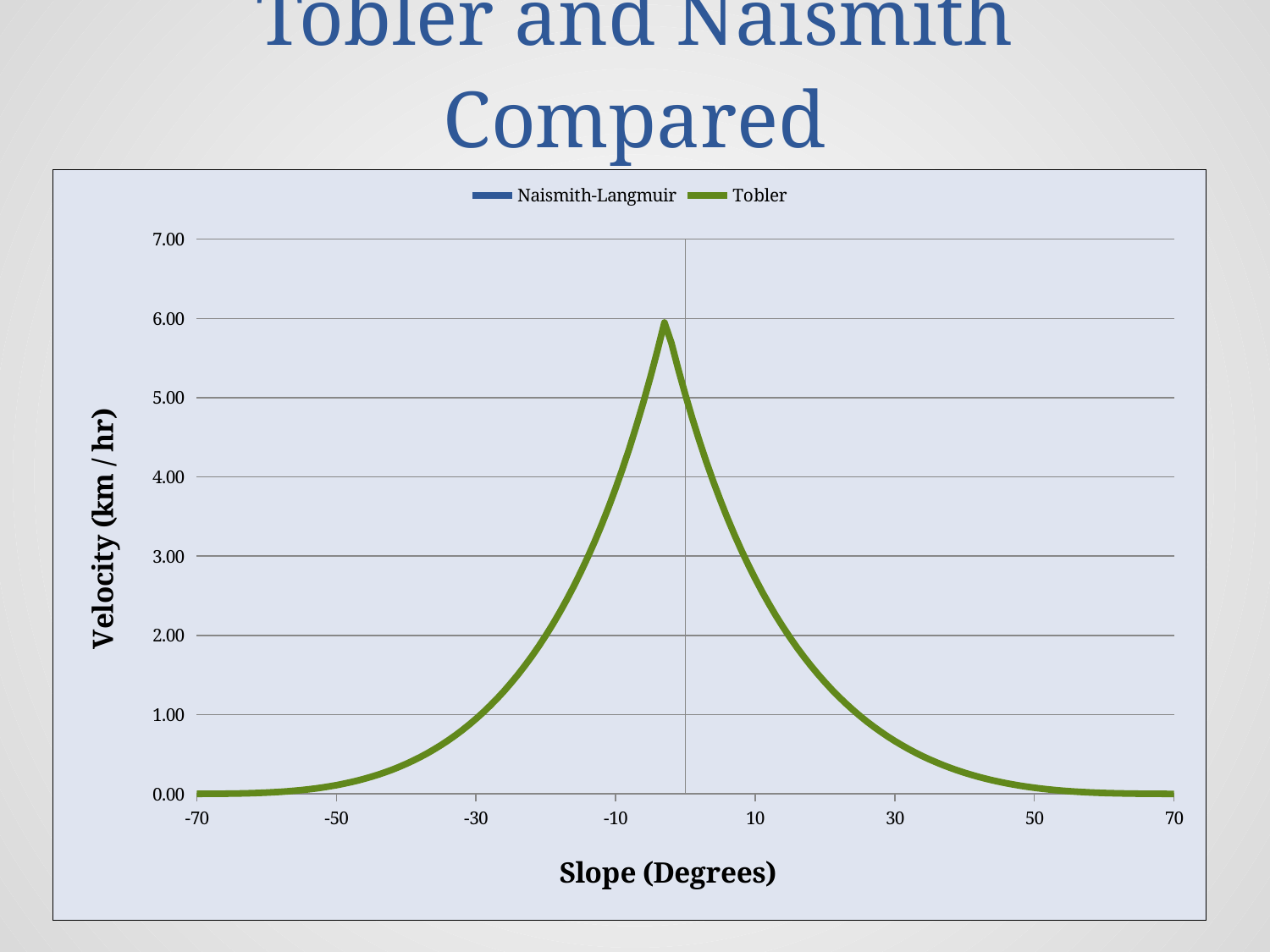
What is the label of the vertical axis? Velocity (km / hr) Which is larger for the Tobler line: the velocity at a slope of -10 degrees or at 10 degrees? -10 degrees Is the peak value of the Tobler line greater or less than 7.00? less What kind of chart is shown on the slide? line chart Is the Tobler velocity at a slope of 50 degrees greater or less than 1.00? less Is the peak value of the Tobler line greater or less than 5.00? greater Does the Tobler line rise or fall as the slope increases from -70 to -10 degrees? rise Does the Tobler line rise or fall as the slope increases from 10 to 70 degrees? fall What are the two series named in the legend? Naismith-Langmuir and Tobler How many series does the legend list? 2